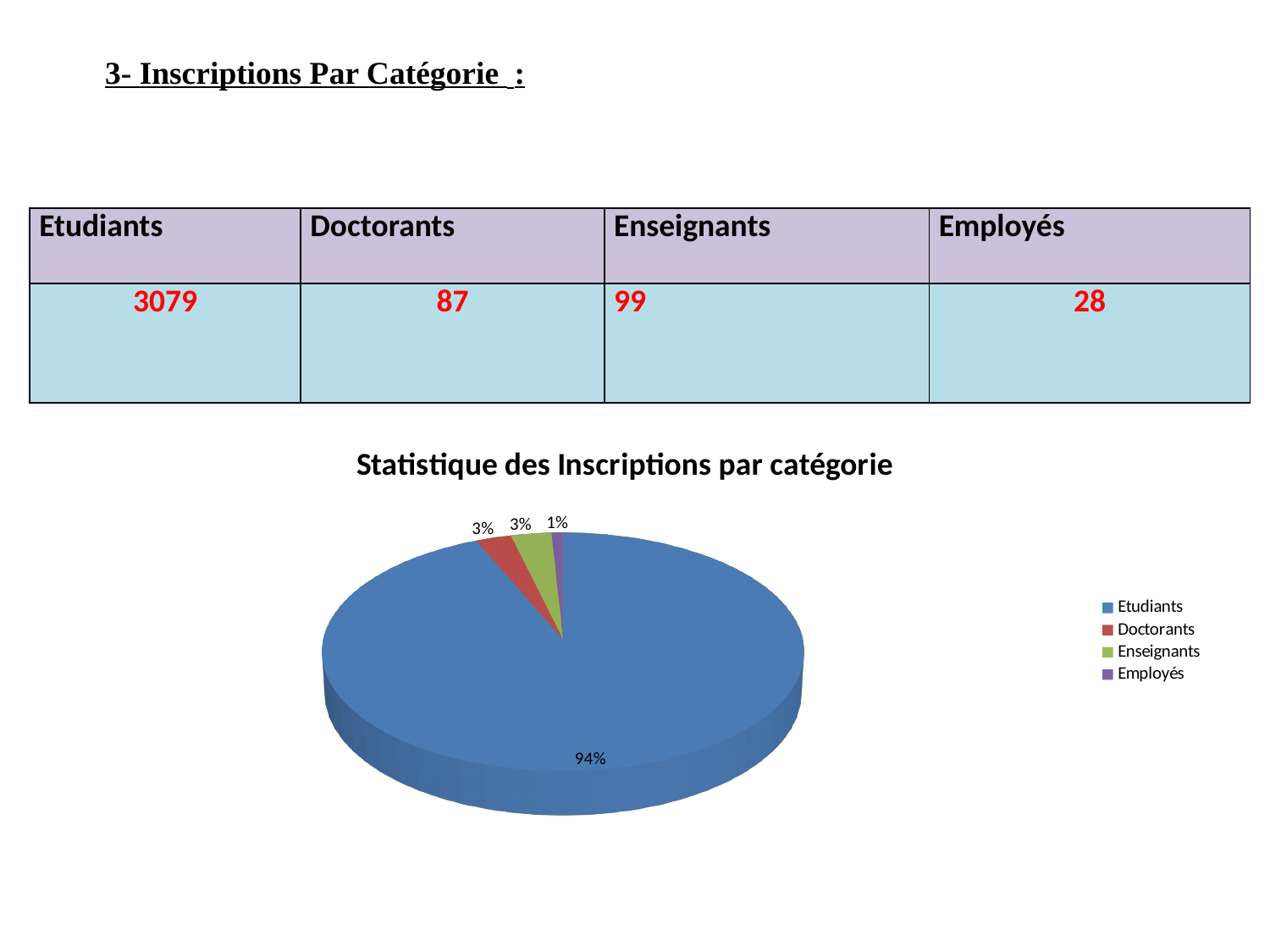
Which slice is larger, Etudiants or Employés? Etudiants What share of the pie does Etudiants represent? 94% How many categories does the pie chart show? 4 What kind of chart is shown on the slide? pie chart Which category has the smallest slice of the pie? Employés Which category has the largest slice of the pie? Etudiants What is the title of the pie chart? Statistique des Inscriptions par catégorie What share of the pie does Employés represent? 1% What share of the pie does Doctorants represent? 3% What is the difference in percentage points between the Etudiants slice and the Employés slice? 93% What colour is the Etudiants slice in the pie chart? blue